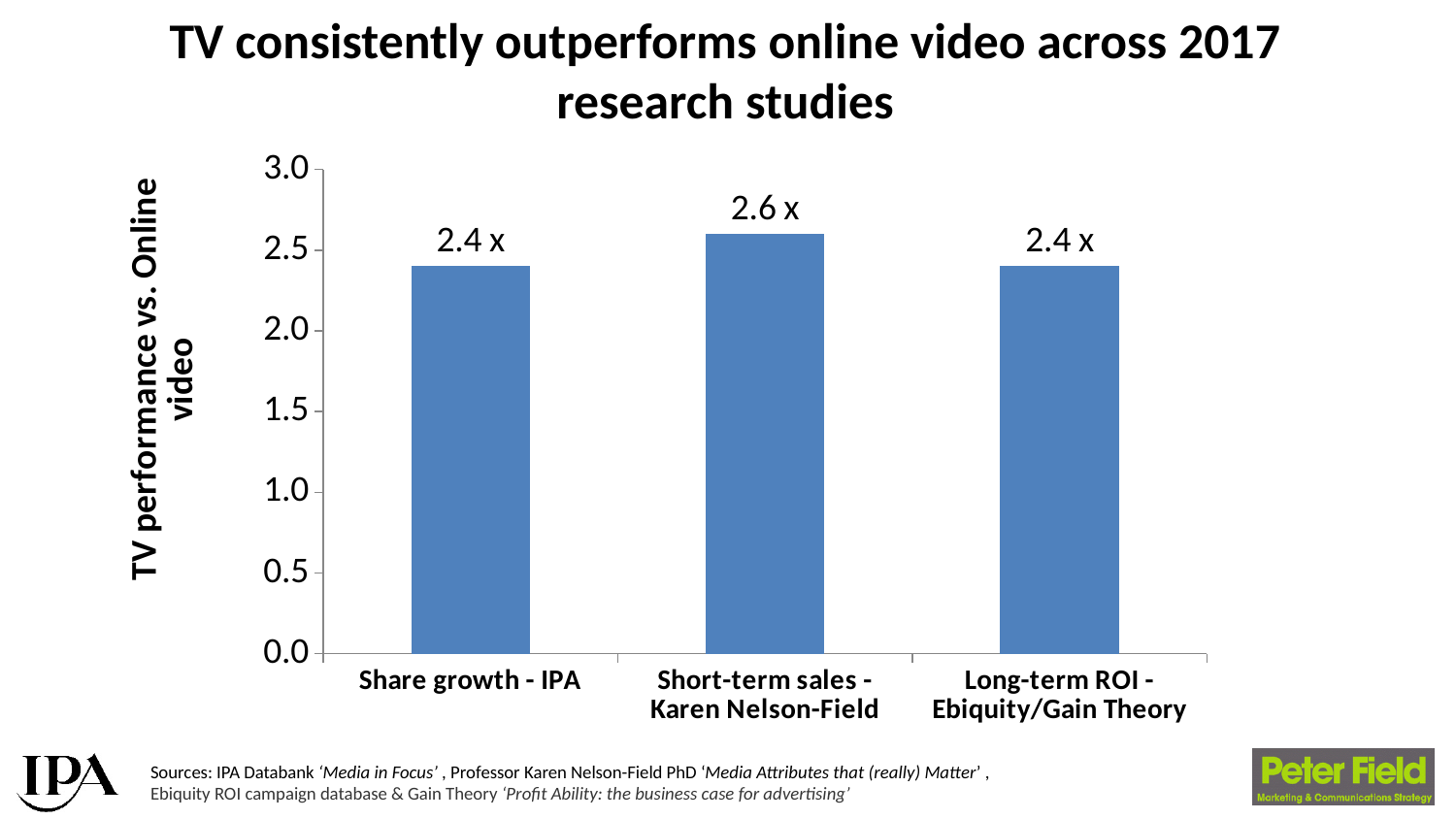
What kind of chart is shown on the slide? Bar chart What is the difference between the value for Short-term sales - Karen Nelson-Field and the value for Share growth - IPA? 0.2 x What is the value for Share growth - IPA? 2.4 x Is the value for Short-term sales - Karen Nelson-Field greater or less than 3.0? less What is the value for Long-term ROI - Ebiquity/Gain Theory? 2.4 x Which category has the highest value? Short-term sales - Karen Nelson-Field What is the value for Short-term sales - Karen Nelson-Field? 2.6 x Which is larger: the value for Short-term sales - Karen Nelson-Field or the value for Long-term ROI - Ebiquity/Gain Theory? Short-term sales - Karen Nelson-Field How many categories are shown on the chart? 3 Is the value for Share growth - IPA greater or less than 2.0? greater What is the label of the vertical axis? TV performance vs. Online video What is the title of the slide? TV consistently outperforms online video across 2017 research studies